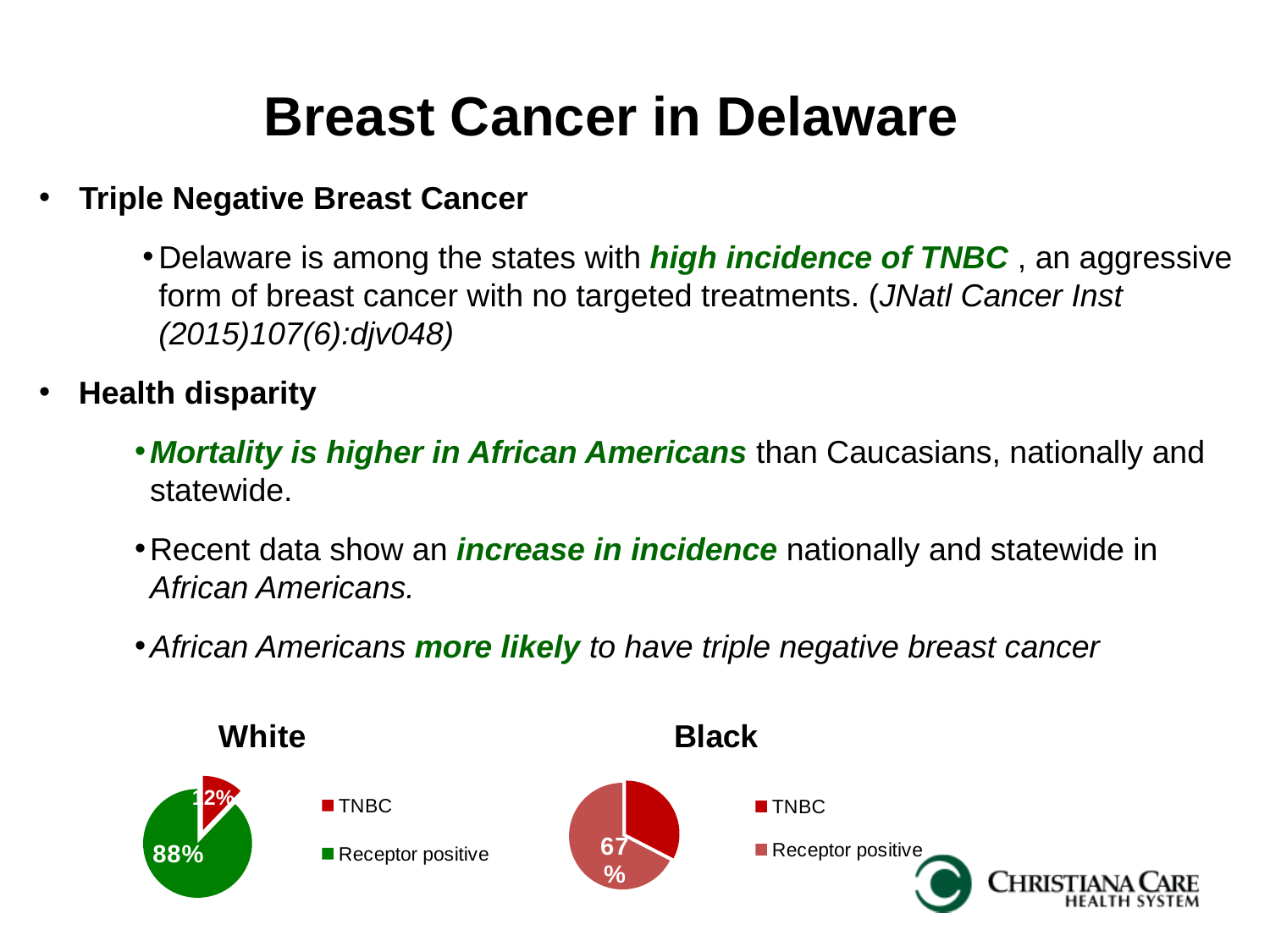
How many entries does the legend of the Black pie chart list? 2 In the White pie chart, what percentage is labelled for Receptor positive? 88% What kind of chart is used for the White and Black data at the bottom of the slide? Pie chart In the White pie chart, what percentage is labelled for TNBC? 12% In the Black pie chart, what percentage is labelled for Receptor positive? 67% In the White pie chart, which slice is the largest? Receptor positive Is the TNBC slice larger in the White pie chart or the Black pie chart? Black In the White pie chart, which slice is the smallest? TNBC In the White pie chart, what is the difference in percentage points between Receptor positive and TNBC? 76 percentage points How many slices does the White pie chart have? 2 In the White pie chart, what colour is the Receptor positive slice? Green In the Black pie chart, which slice is the largest? Receptor positive